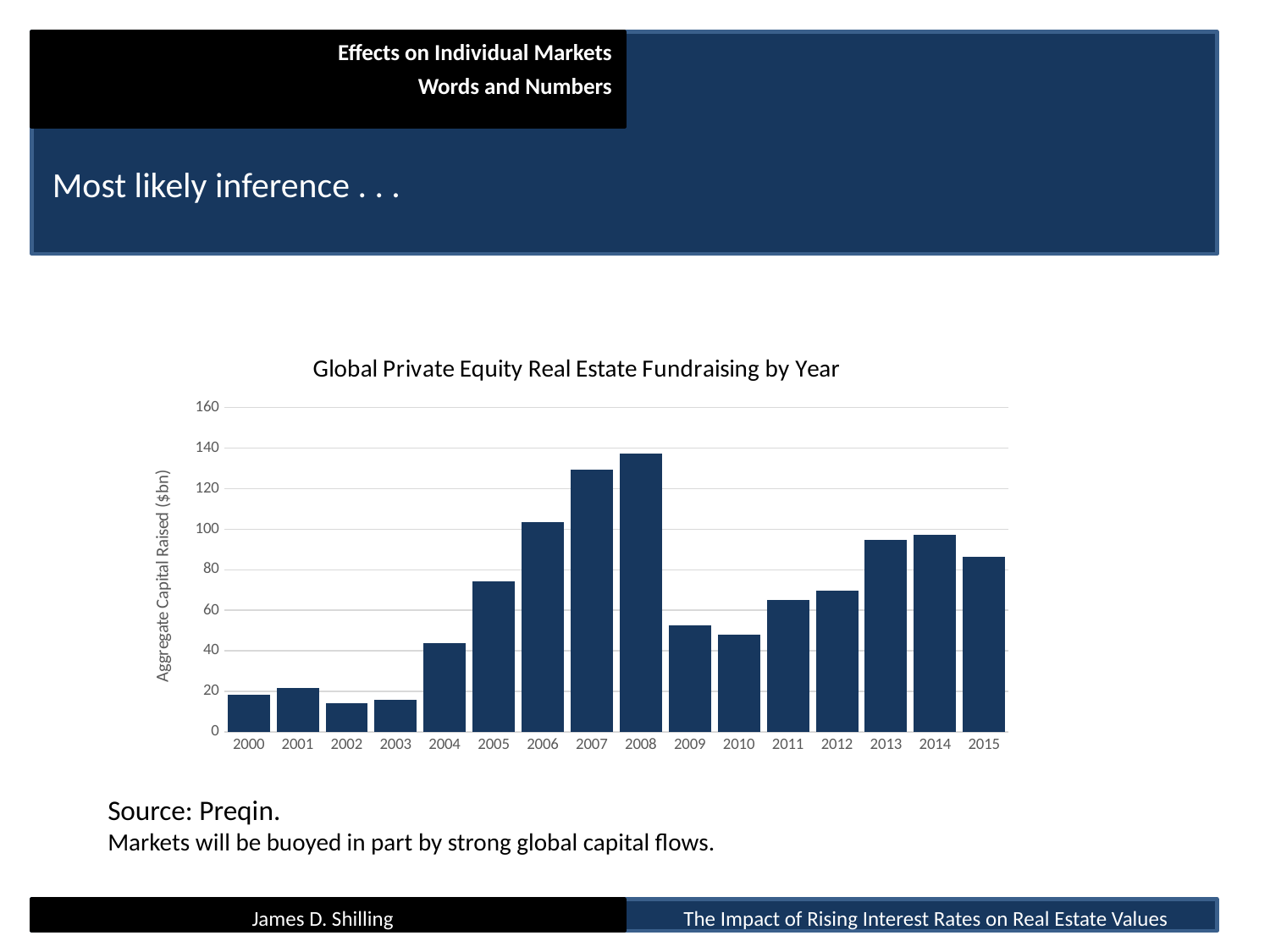
Is the value for 2008 greater or less than 120? greater Is the value for 2002 greater or less than 20? less What is the title of the chart? Global Private Equity Real Estate Fundraising by Year Do the values rise or fall from 2003 to 2008? rise Which year has the larger value, 2005 or 2007? 2007 What kind of chart is shown on the slide? bar chart What is the label on the vertical axis of the chart? Aggregate Capital Raised ($bn) Is the value for 2015 greater or less than 80? greater Which year has the larger value, 2009 or 2010? 2009 Which year has the highest aggregate capital raised? 2008 How many years are shown on the x axis of the chart? 16